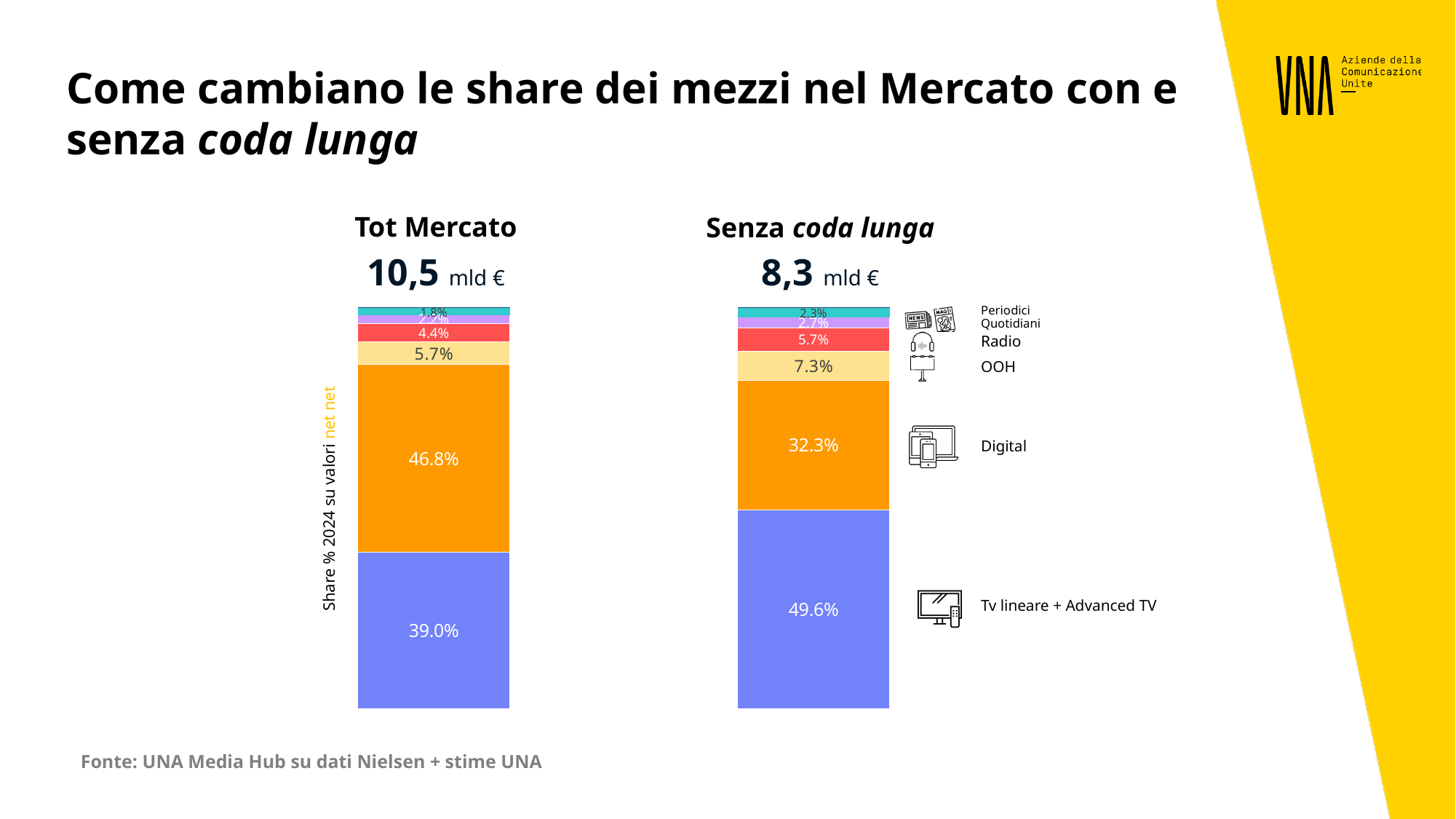
By how many percentage points does the Digital share in Tot Mercato exceed the Digital share in Senza coda lunga? 14.5 percentage points What total market value is shown above the Tot Mercato bar? 10,5 mld € How many media categories are shown in each stacked bar? 6 Which medium has the smallest share in the Tot Mercato bar? Periodici Is the share of Tv lineare + Advanced TV larger in the Tot Mercato bar or in the Senza coda lunga bar? Senza coda lunga What is the share of Radio in the Tot Mercato bar? 4.4% What is the share of Digital in the Tot Mercato bar? 46.8% What is the share of OOH in the Senza coda lunga bar? 7.3% Which medium has the largest share in the Senza coda lunga bar? Tv lineare + Advanced TV Which medium has the largest share in the Tot Mercato bar? Digital What kind of chart is shown on the slide? Stacked bar chart What is the share of Tv lineare + Advanced TV in the Senza coda lunga bar? 49.6%